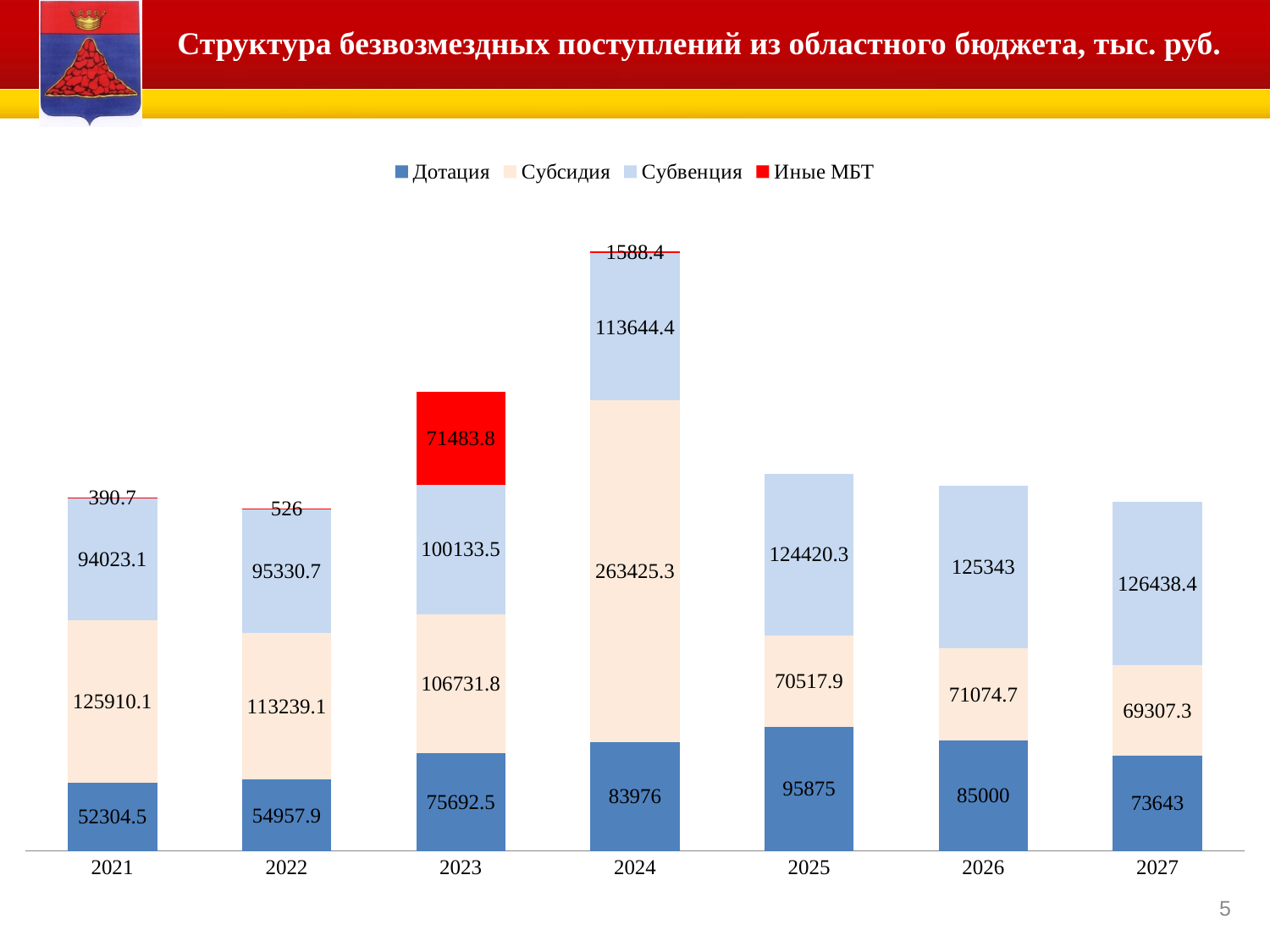
In which year is Субсидия lowest? 2027 How many years are shown on the x axis? 7 What is the difference between Дотация in 2025 and Дотация in 2021? 43570.5 Which is larger: Субсидия in 2021 or Субсидия in 2022? Субсидия in 2021 How many series does the legend list? 4 What is the value of Дотация for 2021? 52304.5 In which year is Дотация highest? 2025 What is the total of the stacked bar for 2025? 290813.2 What is the value of Иные МБТ for 2023? 71483.8 What is the value of Субвенция for 2027? 126438.4 What kind of chart is shown on the slide? Stacked bar chart What is the value of Субсидия for 2024? 263425.3